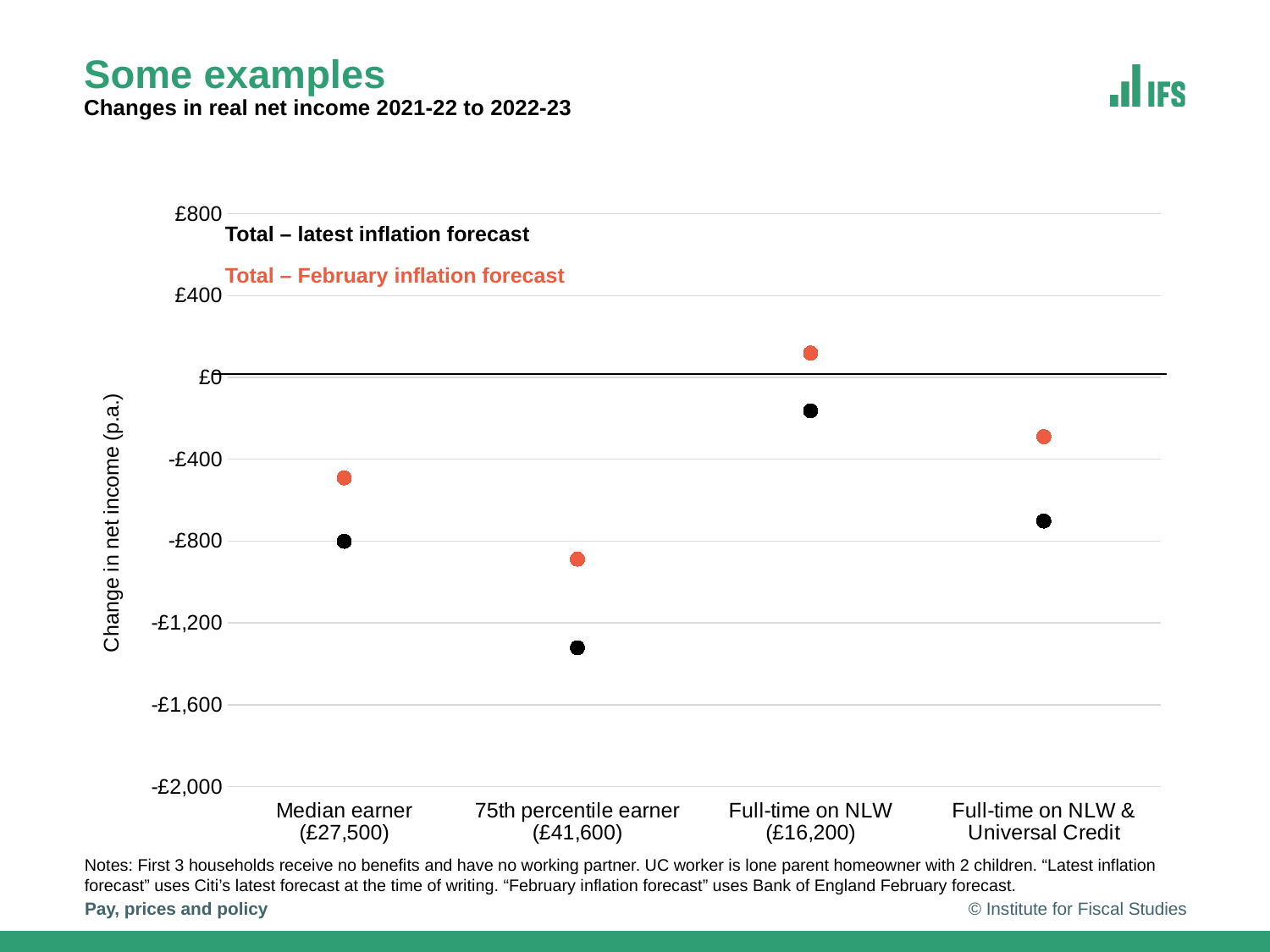
What colour are the markers for the 'Total – February inflation forecast' series? orange Which household has the highest value under the February inflation forecast? Full-time on NLW (£16,200) Which household has the lowest value under the latest inflation forecast? 75th percentile earner (£41,600) What kind of chart is shown on the slide? scatter chart Is the value for the Median earner under the latest inflation forecast greater or less than -£400? less How many household categories are shown on the x axis? 4 Under the latest inflation forecast, which is higher: the value for the Median earner or the value for Full-time on NLW? Full-time on NLW What is the title of the chart's vertical axis? Change in net income (p.a.) Is the value for Full-time on NLW under the February inflation forecast greater or less than £0? greater How many series does the chart's legend list? 2 For the 75th percentile earner, which series shows the higher value: the latest inflation forecast or the February inflation forecast? February inflation forecast Is the value for the 75th percentile earner under the latest inflation forecast greater or less than -£1,200? less